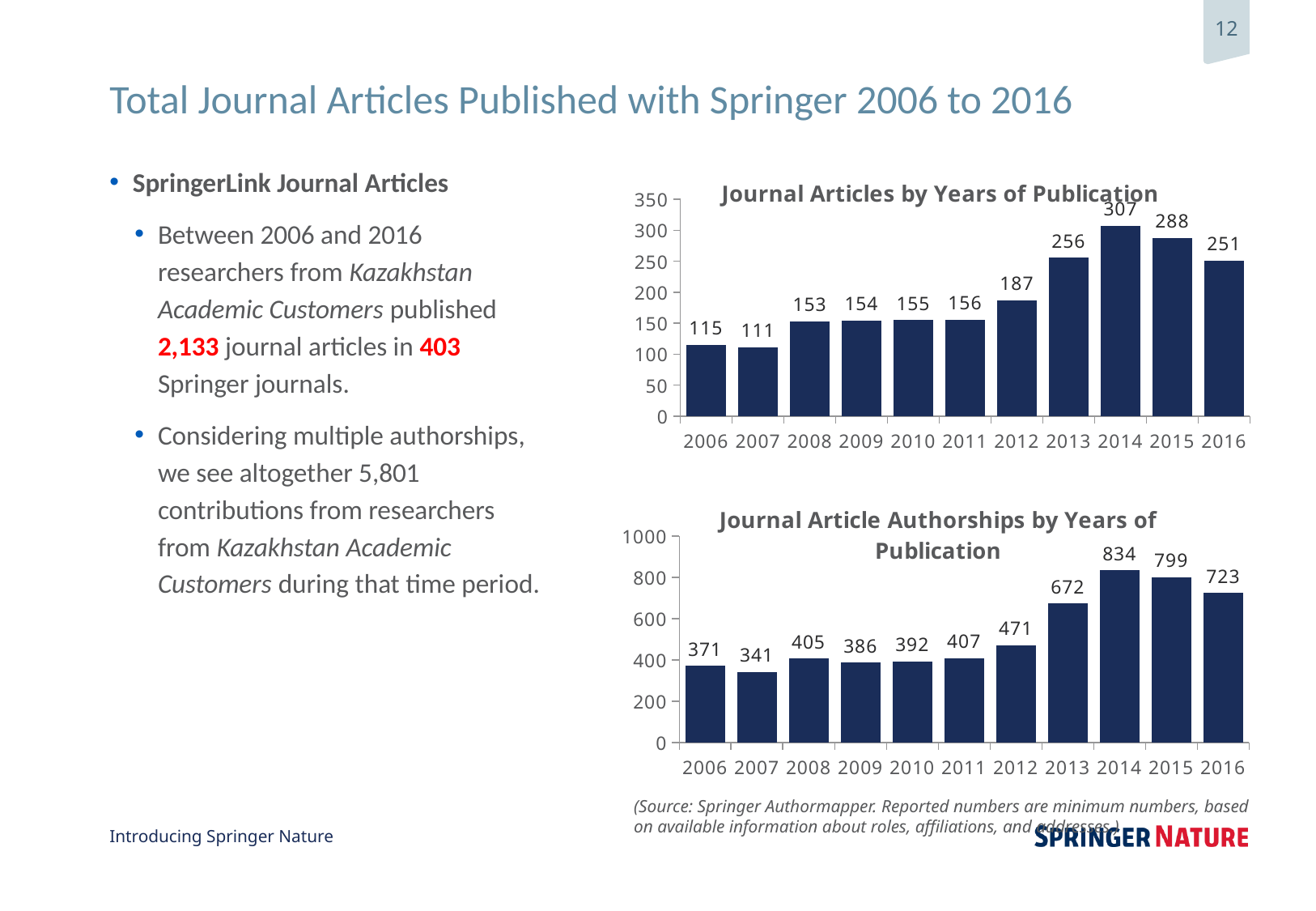
What kind of chart is the 'Journal Articles by Years of Publication' chart? Bar chart In the 'Journal Article Authorships by Years of Publication' chart, which is larger, the value for 2008 or the value for 2011? 2011 In the 'Journal Articles by Years of Publication' chart, which year has the lowest value? 2007 In the 'Journal Article Authorships by Years of Publication' chart, is the value for 2012 greater or less than 400? greater In the 'Journal Article Authorships by Years of Publication' chart, which year has the highest value? 2014 In the 'Journal Article Authorships by Years of Publication' chart, what is the value for 2013? 672 In the 'Journal Articles by Years of Publication' chart, what is the value for 2012? 187 In the 'Journal Article Authorships by Years of Publication' chart, which year has the lowest value? 2007 In the 'Journal Articles by Years of Publication' chart, how many years are shown on the x axis? 11 In the 'Journal Article Authorships by Years of Publication' chart, what is the difference between the values for 2015 and 2016? 76 In the 'Journal Articles by Years of Publication' chart, which year has the highest value? 2014 In the 'Journal Articles by Years of Publication' chart, what is the difference between the values for 2014 and 2016? 56